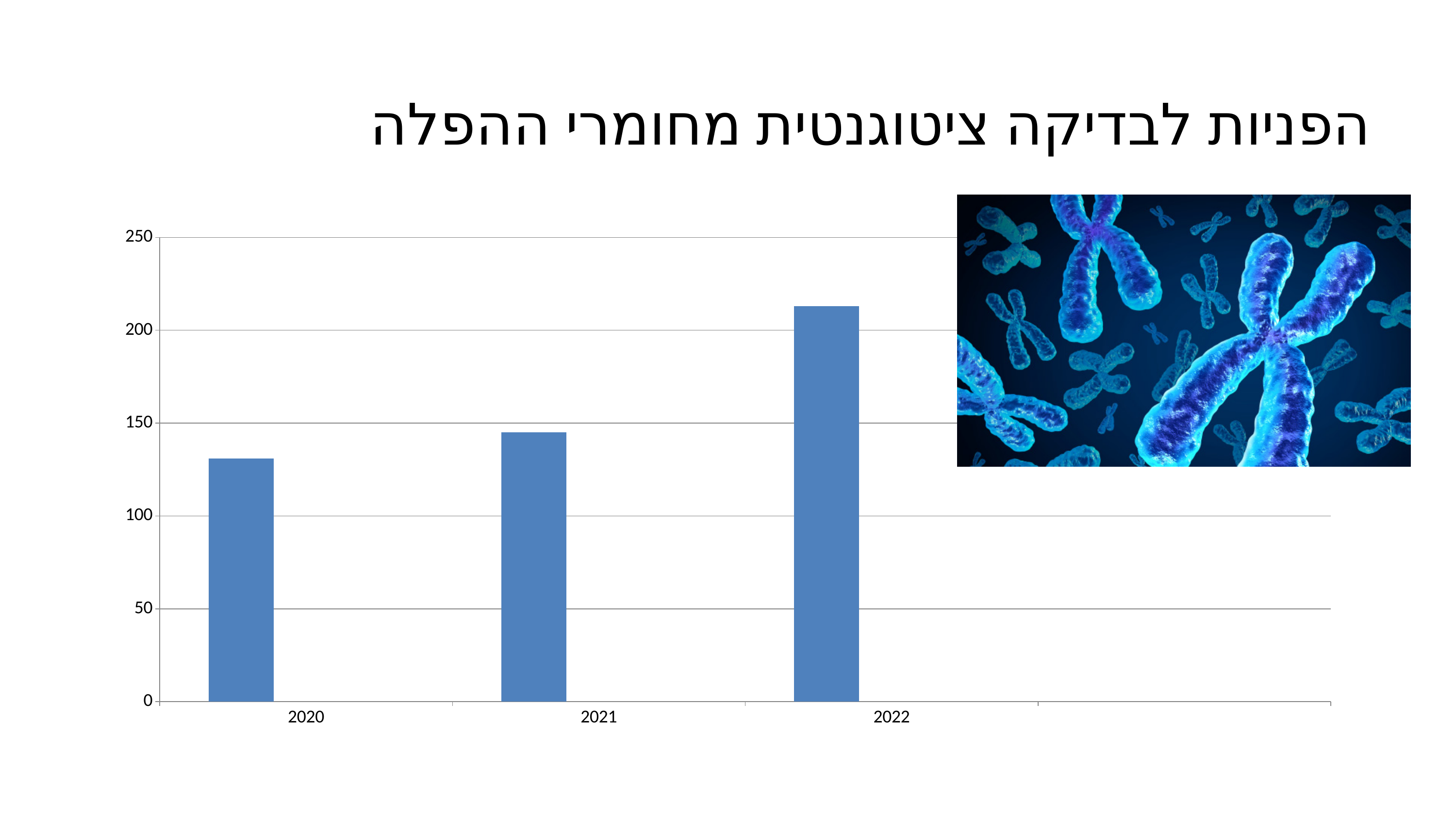
Is the value for 2022 greater or less than 250? less Is the value for 2022 greater or less than 200? greater What kind of chart is shown on the slide? bar chart How many years (categories) are plotted on the chart? 3 Which is larger, the value for 2022 or the value for 2020? 2022 Which year has the lowest bar? 2020 Do the values rise or fall from 2020 to 2022? rise What is the title of the slide above the chart? הפניות לבדיקה ציטוגנטית מחומרי ההפלה Which is larger, the value for 2021 or the value for 2020? 2021 Is the value for 2020 greater or less than 100? greater Which year has the highest bar? 2022